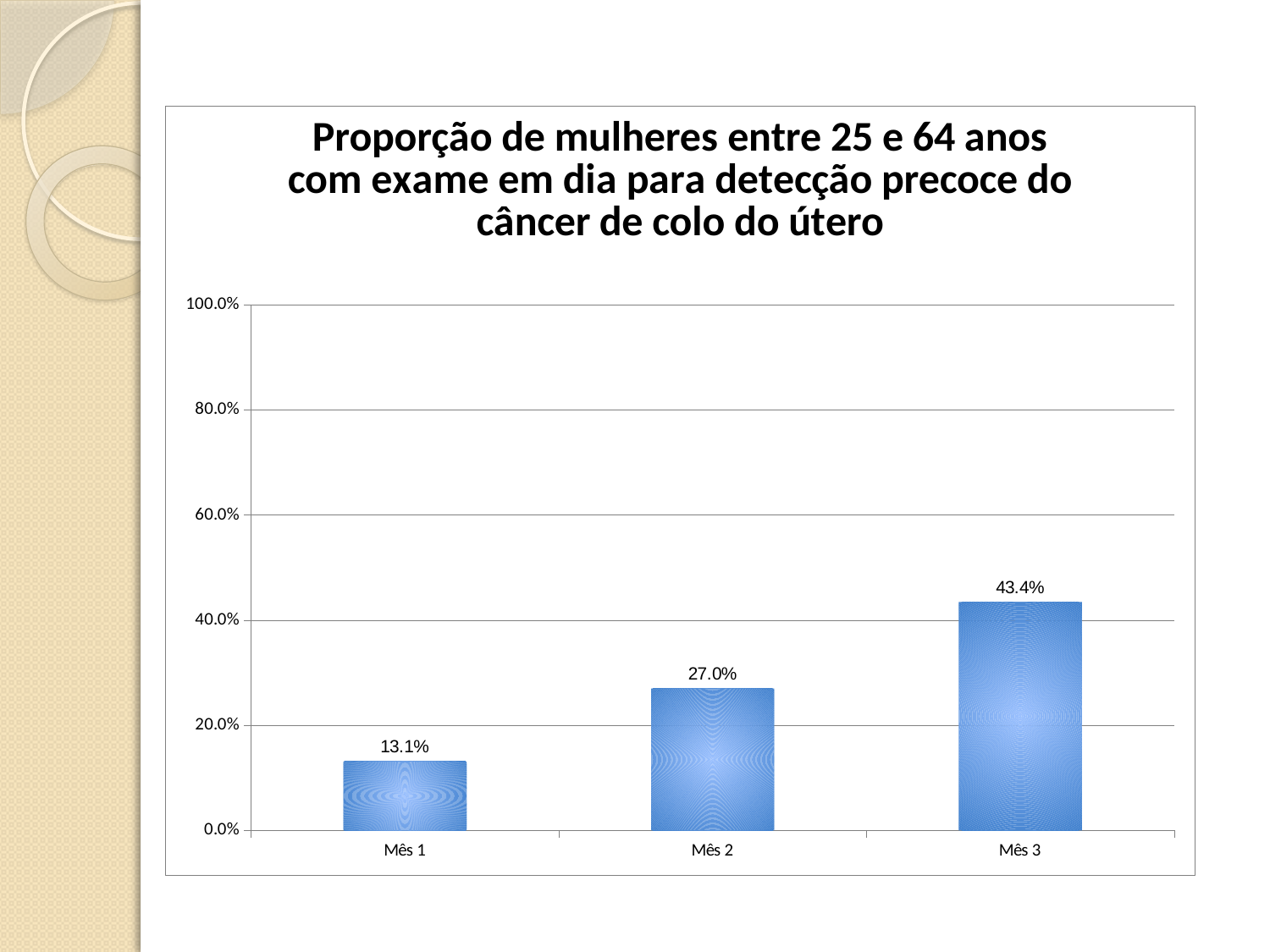
Do the values rise or fall from Mês 1 to Mês 3? rise What is the difference between the values for Mês 3 and Mês 1? 30.3% Which month has the lowest value? Mês 1 What is the value for Mês 1? 13.1% What kind of chart is shown on the slide? bar chart What is the value for Mês 3? 43.4% Which month has the highest value? Mês 3 Is the value for Mês 3 greater or less than 40.0%? greater What is the difference between the values for Mês 2 and Mês 1? 13.9% What is the value for Mês 2? 27.0% How many months are shown on the x axis? 3 Which is larger, the value for Mês 2 or the value for Mês 3? Mês 3